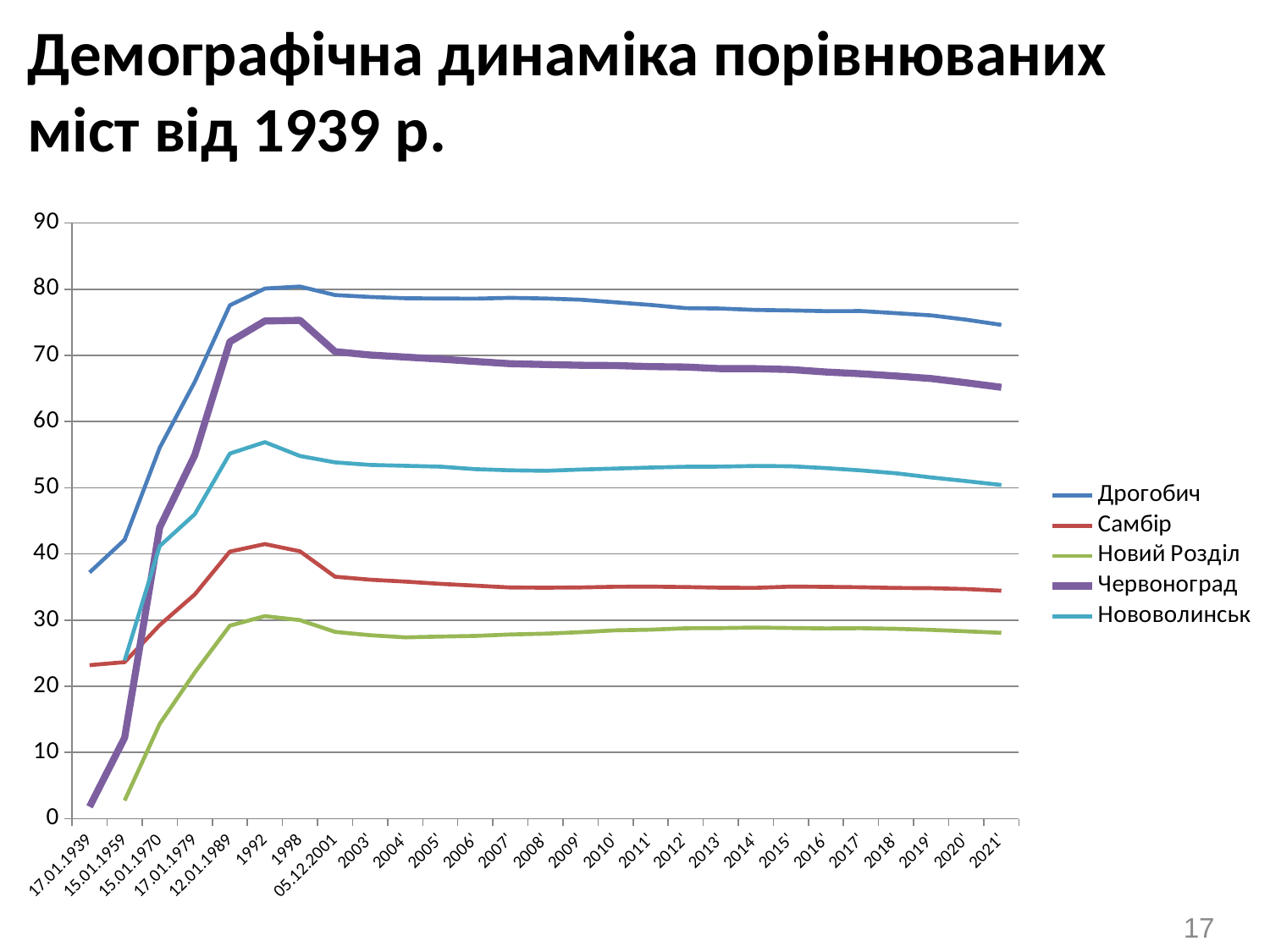
Does the value for Червоноград rise or fall between 17.01.1939 and 1992? rise What kind of chart is shown on the slide? line chart What is the title of the chart on the slide? Демографічна динаміка порівнюваних міст від 1939 р. Is the value for Самбір at 2021' greater or less than 40? less Which city has the lowest value at 2021'? Новий Розділ Is the value for Червоноград at 2021' greater or less than 70? less Which city has the lowest value at 17.01.1939? Червоноград How many series does the legend list? 5 Which city has the highest value at 2021'? Дрогобич Which is larger at 2010', the value for Самбір or the value for Новий Розділ? Самбір Is the value for Нововолинськ at 1992 greater or less than 50? greater